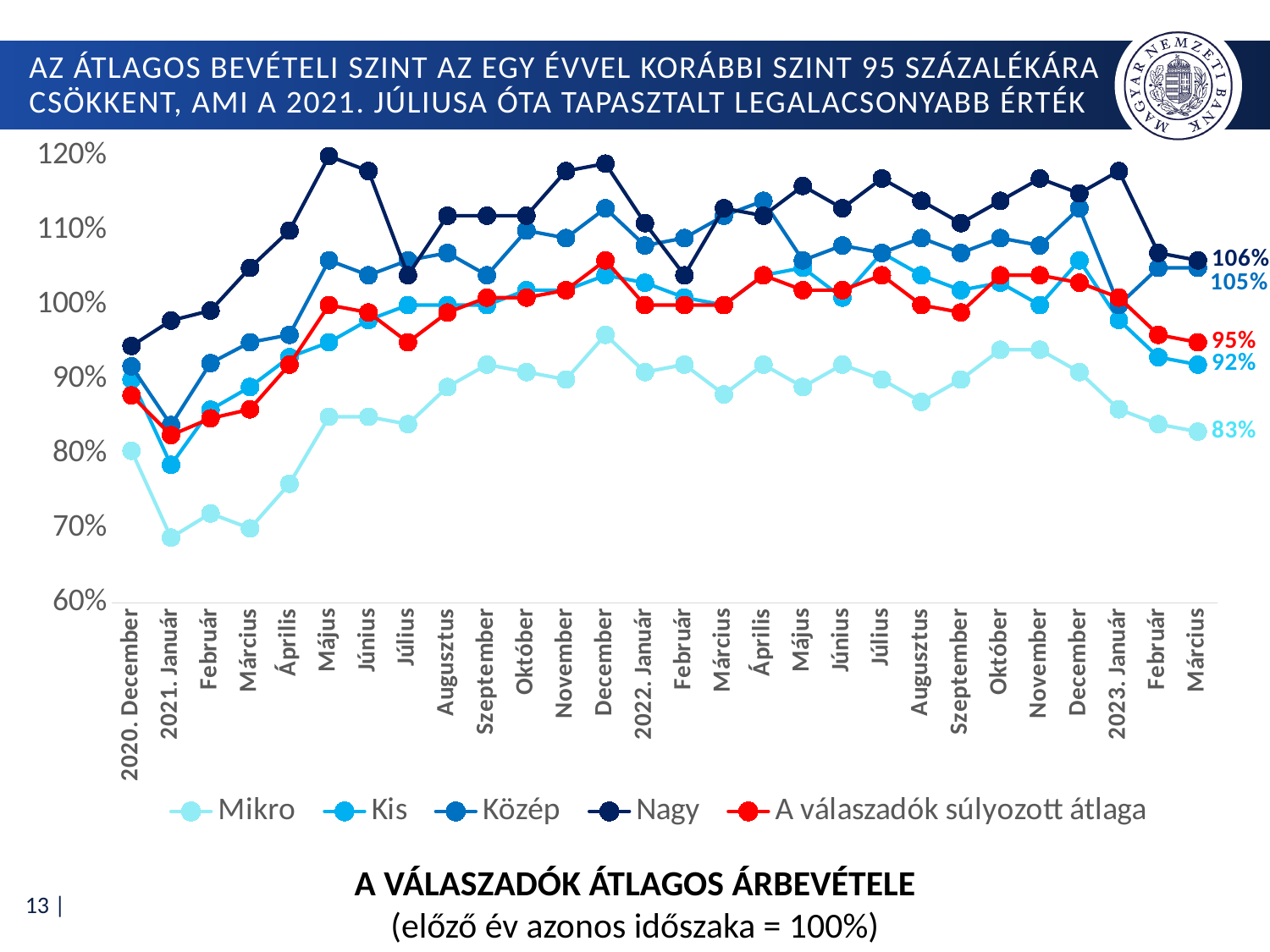
What is the value of the Kis series in 2023 Március? 92% What kind of chart is shown on the slide? Line chart What is the value of the Mikro series in 2023 Március? 83% What is the difference between the Nagy and Mikro values in 2023 Március? 23 percentage points Is the value for Mikro in 2021. Január greater or less than 70%? less Which series has the highest value in 2023 Március? Nagy What is the value of the Nagy series in 2023 Március? 106% In 2023 Március, which is larger: the Közép value or the Kis value? Közép How many series does the legend list? 5 Which series has the lowest value in 2023 Március? Mikro What is the value of 'A válaszadók súlyozott átlaga' in 2023 Március? 95% Is the value for Nagy in 2021 Május greater or less than 110%? greater